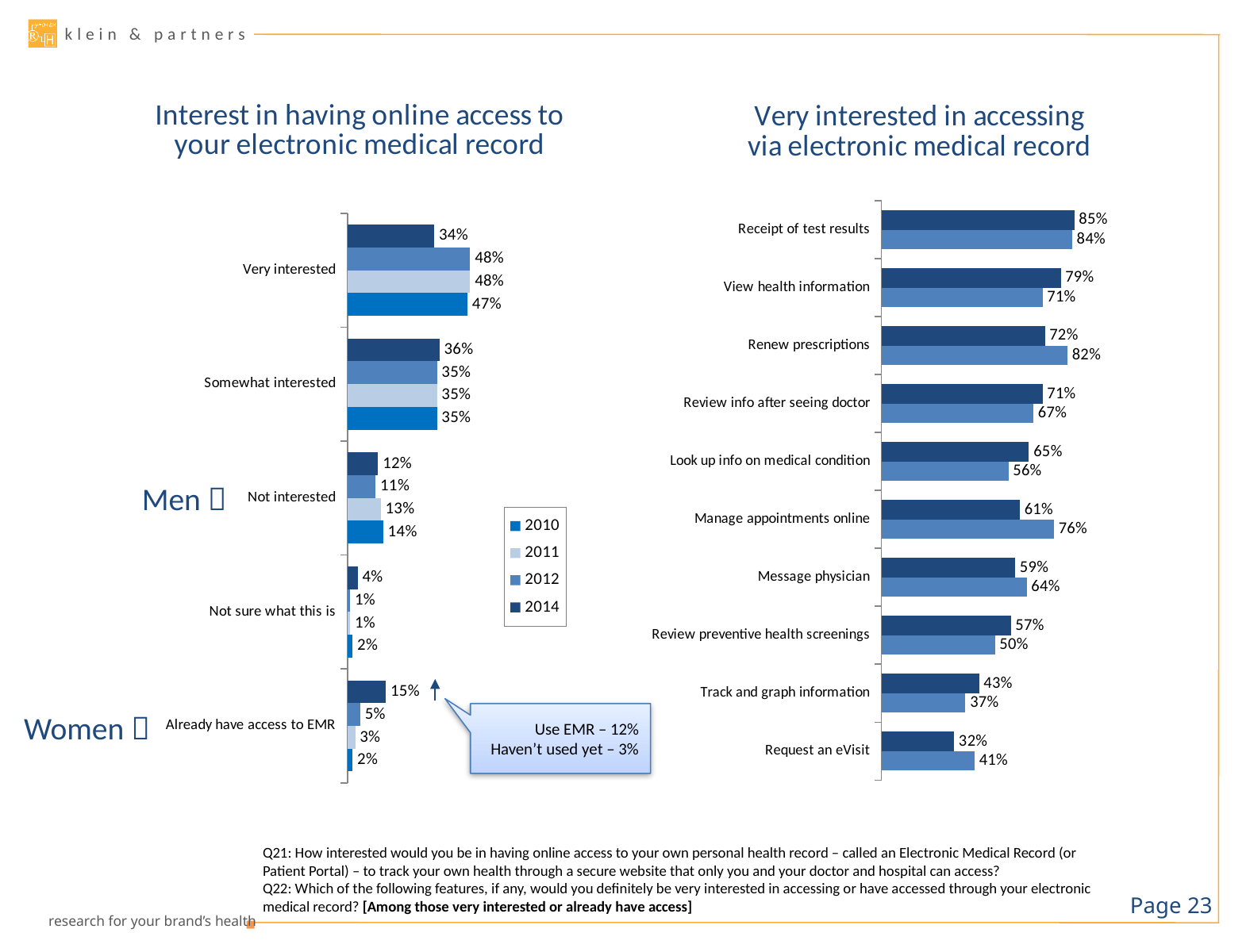
In the right chart 'Very interested in accessing via electronic medical record', what is the difference between the two bars for 'Renew prescriptions'? 10% In the right chart 'Very interested in accessing via electronic medical record', which is larger for 'Manage appointments online': the top (dark blue) bar or the bottom (lighter blue) bar? The bottom (lighter blue) bar In the left chart 'Interest in having online access to your electronic medical record', what is the 2010 value for 'Already have access to EMR'? 2% In the left chart 'Interest in having online access to your electronic medical record', how many categories are shown? 5 In the left chart 'Interest in having online access to your electronic medical record', which year has the highest value for 'Already have access to EMR'? 2014 In the left chart 'Interest in having online access to your electronic medical record', what is the difference between the 2012 and 2014 values for 'Very interested'? 14% In the left chart 'Interest in having online access to your electronic medical record', how many series does the legend list? 4 In the left chart 'Interest in having online access to your electronic medical record', what is the 2014 value for 'Very interested'? 34% In the right chart 'Very interested in accessing via electronic medical record', what is the value of the top (dark blue) bar for 'Receipt of test results'? 85% In the right chart 'Very interested in accessing via electronic medical record', which category has the lowest value for the top (dark blue) bar? Request an eVisit In the right chart 'Very interested in accessing via electronic medical record', how many categories are shown? 10 What kind of chart is the right chart 'Very interested in accessing via electronic medical record'? Bar chart